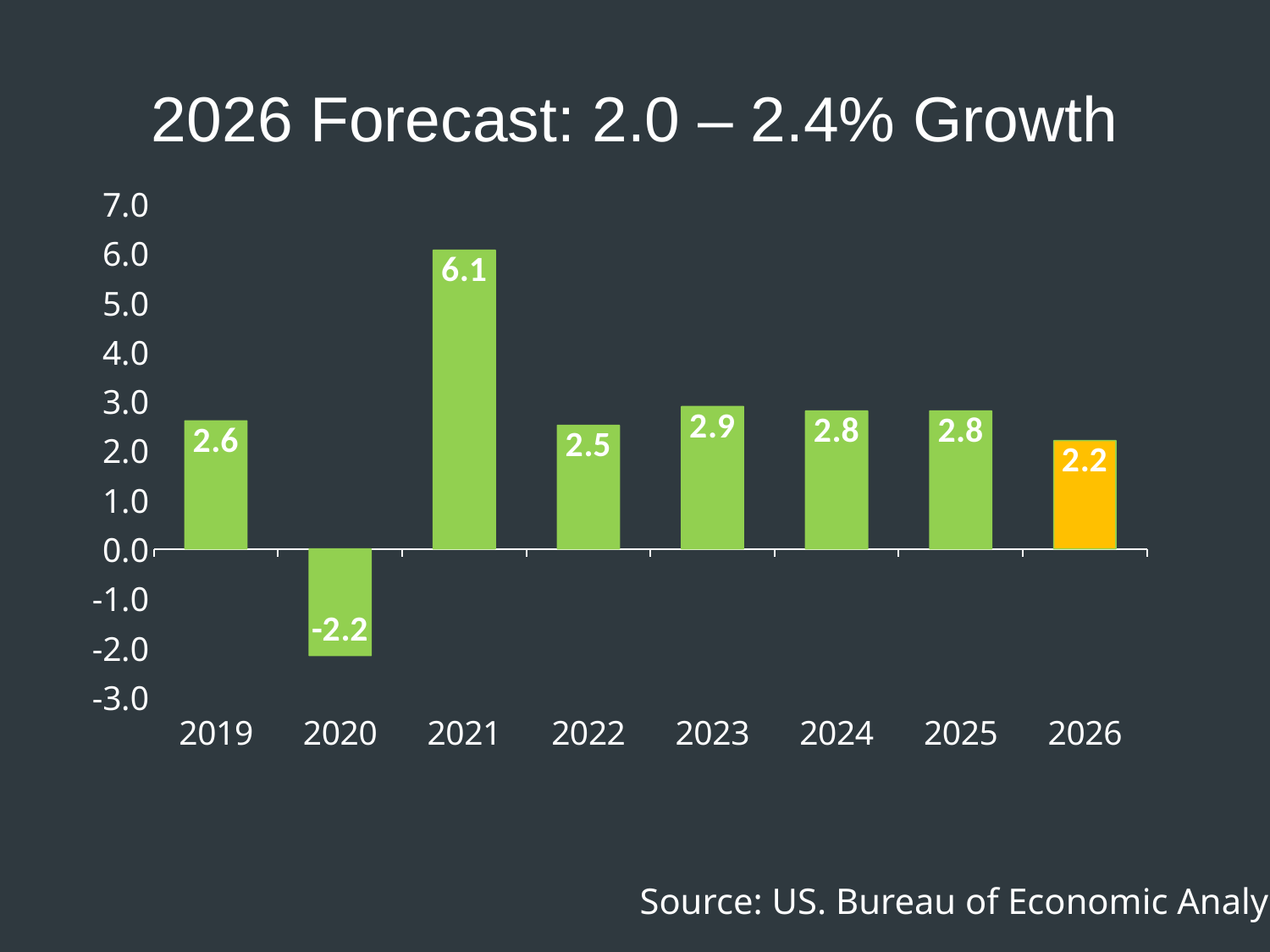
What kind of chart is shown on the slide? bar chart Which year has the highest value? 2021 Is the value for 2021 greater or less than 5.0? greater What is the difference between the values for 2021 and 2022? 3.6 Which bar is coloured differently from the others? 2026 Do the values rise or fall from 2023 to 2026? fall What is the value for 2026? 2.2 Which year has the lowest value? 2020 What is the value for 2020? -2.2 Which is larger, the value for 2019 or the value for 2023? 2023 What is the value for 2021? 6.1 How many years are shown on the x axis? 8